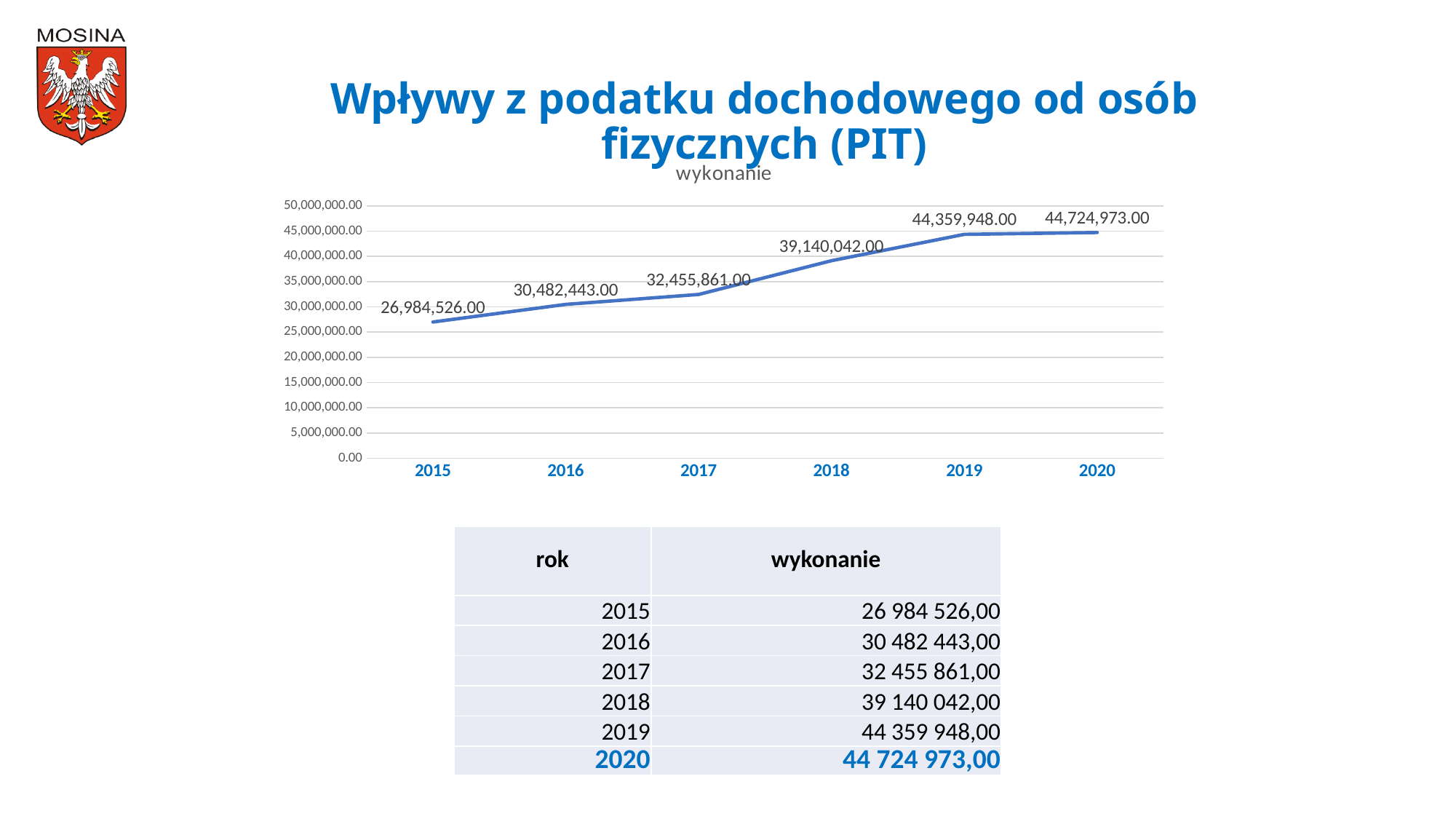
Which year has the lowest value on the chart? 2015 Do the values rise or fall from 2015 to 2020? rise What is the value for 2015 on the chart? 26,984,526.00 Which is larger, the value for 2017 or the value for 2016? 2017 How many years are plotted on the chart? 6 Which year has the highest value on the chart? 2020 What is the difference between the values for 2019 and 2018? 5,219,906.00 Is the value for 2018 greater or less than 35,000,000.00? greater What is the value for 2020 on the chart? 44,724,973.00 What is the value for 2018 on the chart? 39,140,042.00 What is the difference between the values for 2020 and 2019? 365,025.00 What kind of chart is shown on the slide? line chart